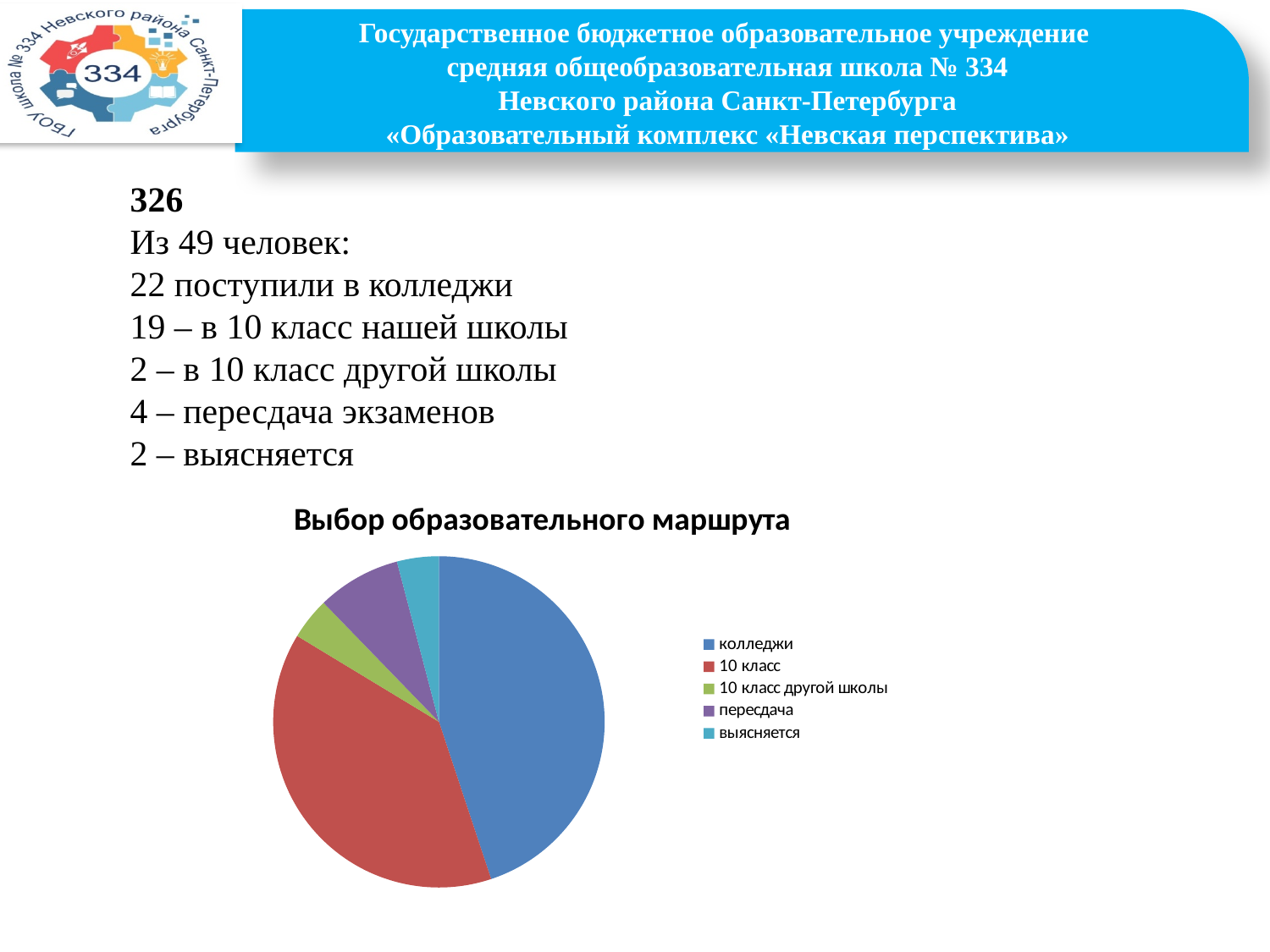
Which category has the largest slice in the pie chart? колледжи What is the title of the chart? Выбор образовательного маршрута According to the slide, how many students in total are represented in the pie chart? 49 According to the slide, how many students does the пересдача slice represent? 4 How many entries does the chart legend list? 5 According to the slide, how many students does the колледжи slice represent? 22 How many slices does the pie chart have? 5 Which slice is larger: пересдача or 10 класс другой школы? пересдача What colour is the колледжи slice in the pie chart? blue What kind of chart is shown on the slide? pie chart According to the slide, how many students does the 10 класс slice represent? 19 Which slice is larger: колледжи or 10 класс? колледжи